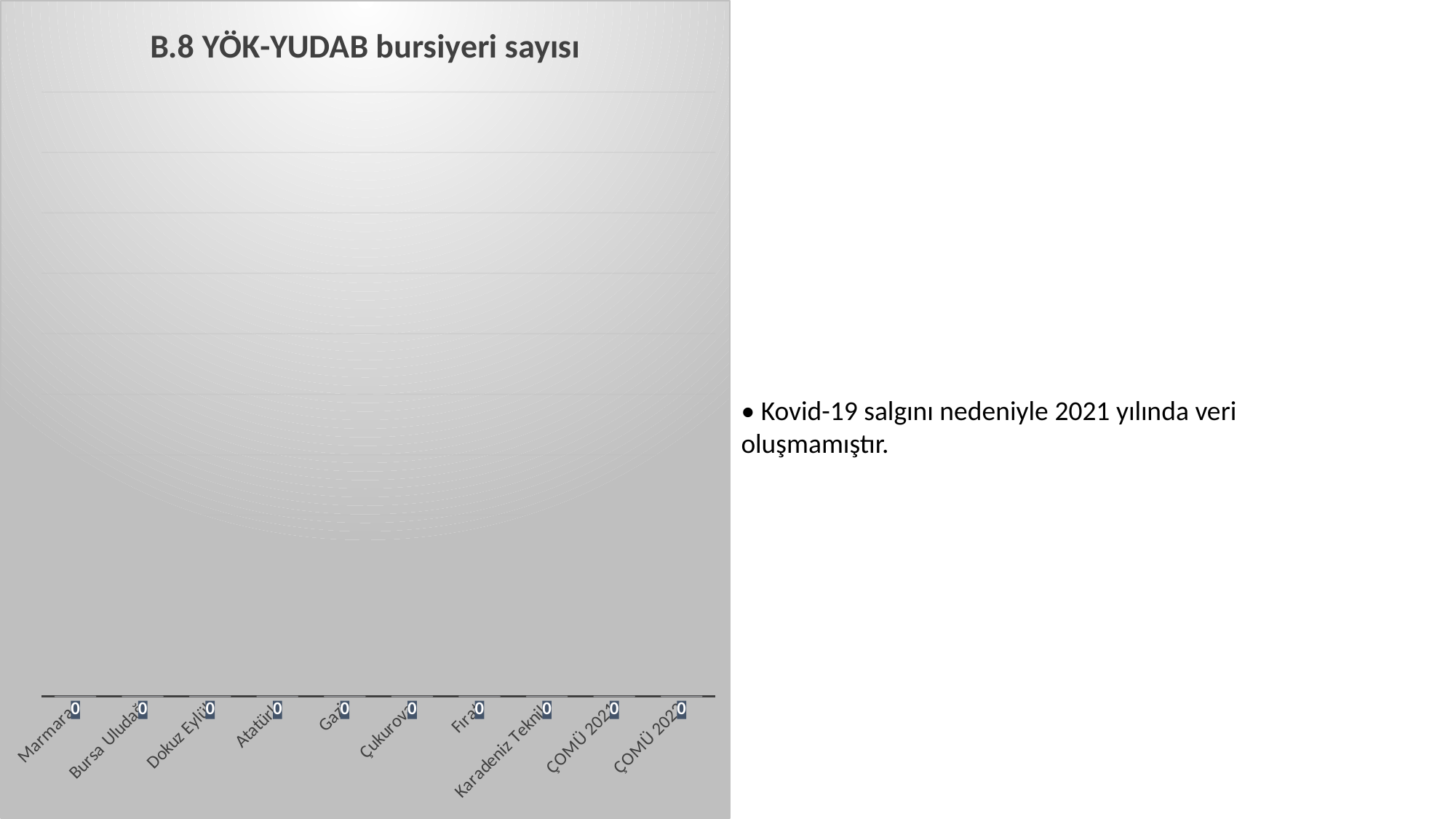
What is the value shown for Karadeniz Teknik? 0 What is the value shown for Marmara? 0 What is the value shown for Dokuz Eylül? 0 What is the title of the chart? B.8 YÖK-YUDAB bursiyeri sayısı What is the value shown for Bursa Uludağ? 0 Do the values rise, fall, or stay flat across the categories on the x axis? stay flat How many categories are shown on the x axis of the chart? 10 What is the value shown for ÇOMÜ 2021? 0 What is the difference between the values for Gazi and Çukurova? 0 What kind of chart is shown on the slide? bar chart